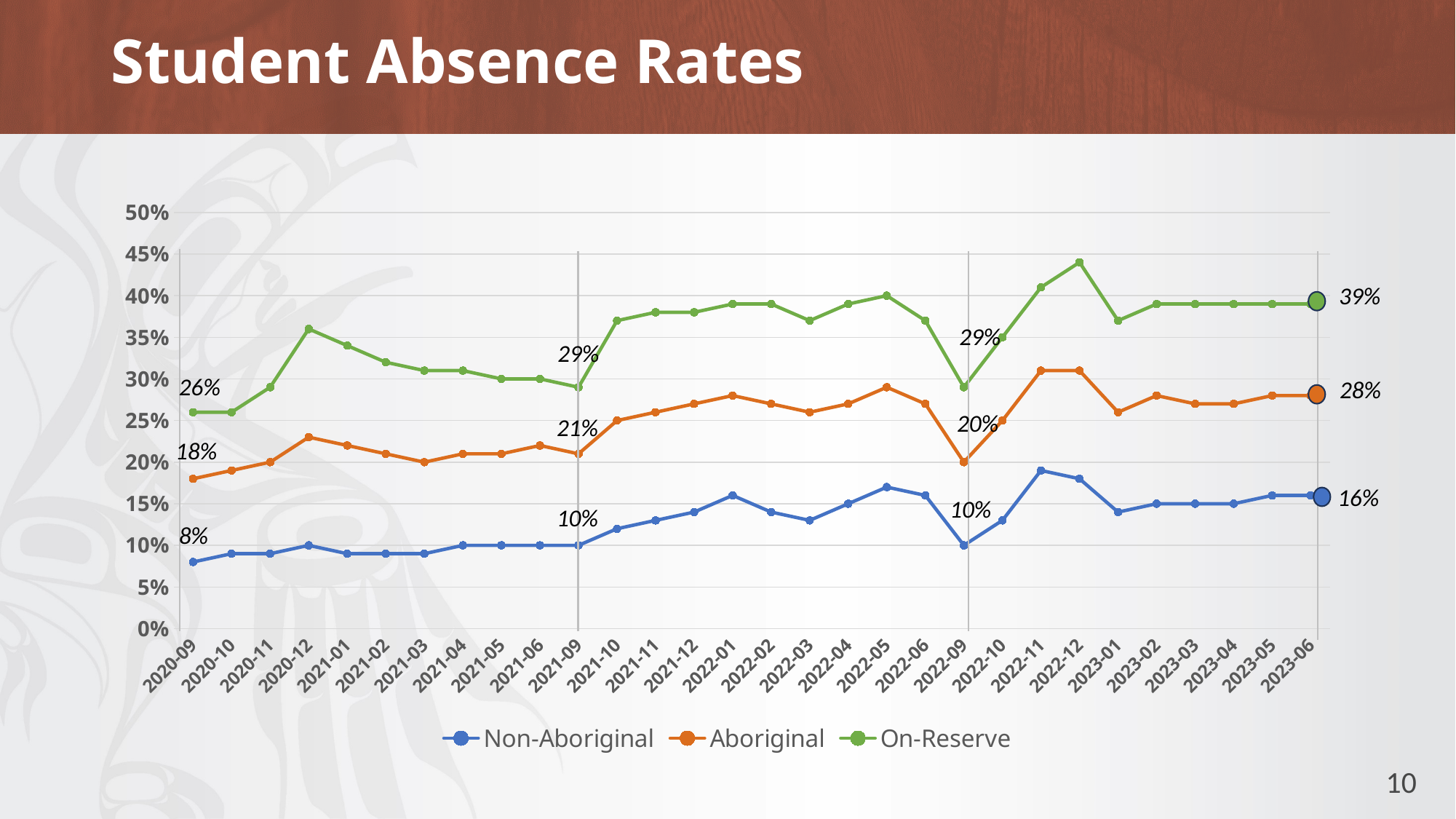
What is the Aboriginal absence rate in 2022-09? 20% Is the Aboriginal absence rate in 2022-11 greater or less than 30%? greater Is the On-Reserve absence rate in 2022-12 greater or less than 40%? greater Which series has the lowest absence rate in 2020-09? Non-Aboriginal What is the Aboriginal absence rate in 2021-09? 21% How many series does the legend list? 3 What type of chart is shown on the slide? Line chart What is the difference between the On-Reserve and Non-Aboriginal absence rates in 2023-06? 23% What is the Non-Aboriginal absence rate in 2020-09? 8% Which series has the highest absence rate in 2023-06? On-Reserve What is the title of the chart on the slide? Student Absence Rates What is the On-Reserve absence rate in 2023-06? 39%